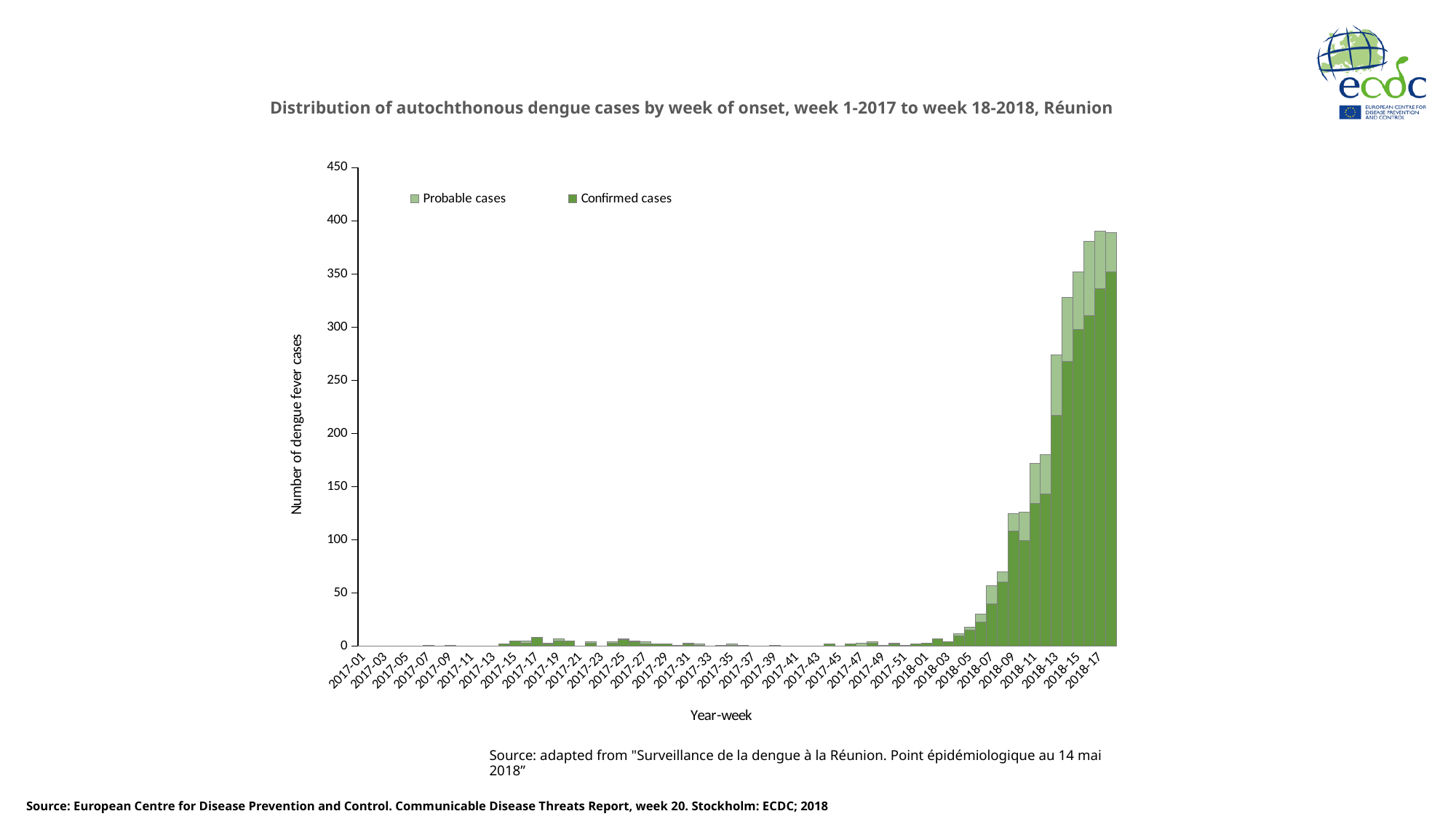
Is the total number of cases for week 2018-09 greater or less than 150? less Is the total number of cases for week 2018-17 greater or less than 350? greater Is the total number of cases for week 2018-05 greater or less than 50? less Which week has the larger total number of cases, 2018-07 or 2018-11? 2018-11 How many series does the legend list? 2 Do the weekly case totals rise or fall across the 2018 weeks shown on the x axis? Rise What kind of chart is shown on the slide? Stacked bar chart What are the two series named in the legend? Probable cases and Confirmed cases Which week has the larger total number of cases, 2018-13 or 2018-09? 2018-13 What is the title of the chart? Distribution of autochthonous dengue cases by week of onset, week 1-2017 to week 18-2018, Réunion